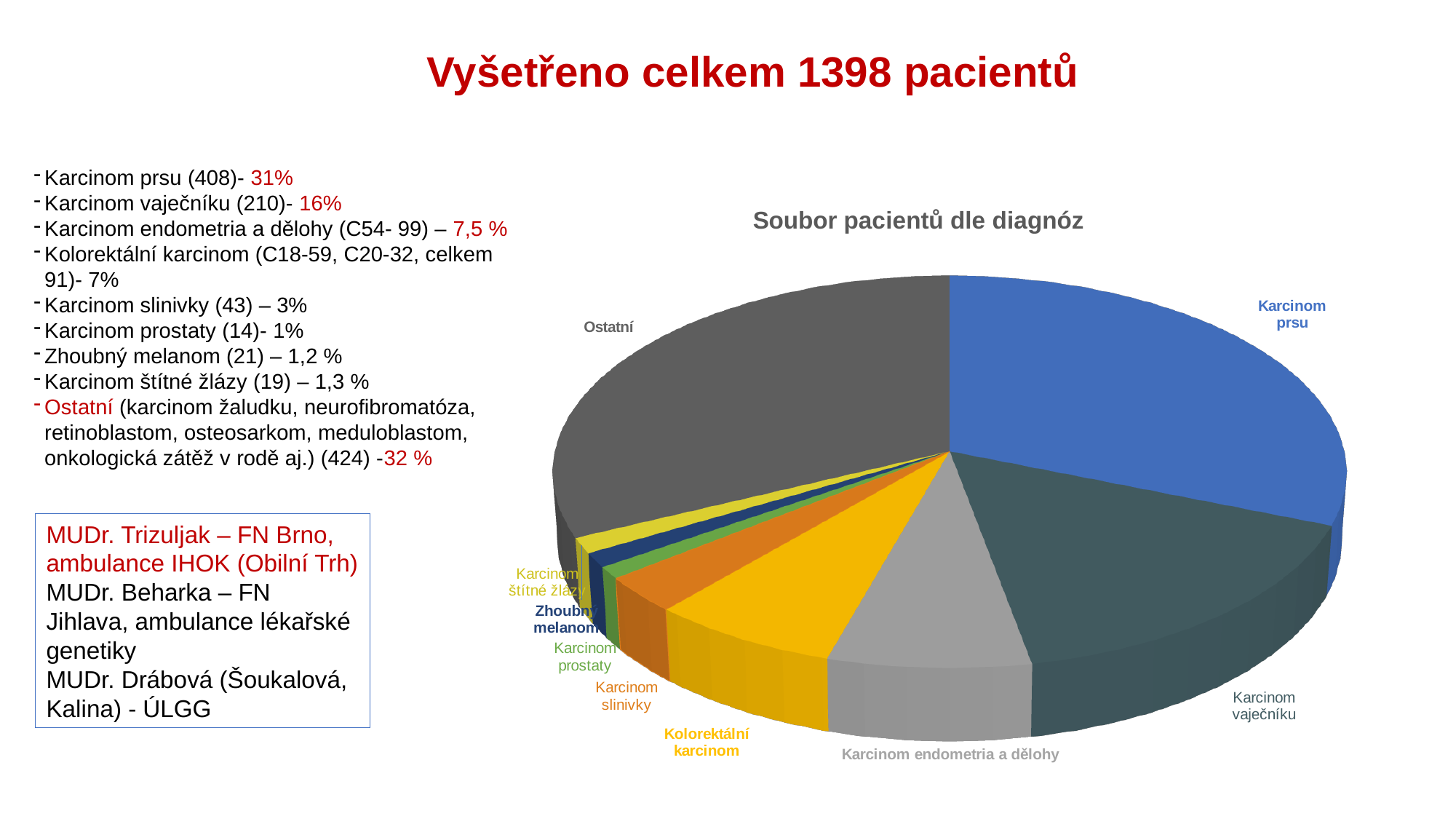
How many slices does the pie chart have? 9 How many patients are in the Karcinom prsu category? 408 How many patients are in the Karcinom vaječníku category? 210 Which category has the largest slice of the pie? Ostatní Which is larger, the slice for Karcinom vaječníku or the slice for Karcinom endometria a dělohy? Karcinom vaječníku What share of the pie does Ostatní represent? 32 % What is the title of the chart? Soubor pacientů dle diagnóz What is the difference in patient count between Karcinom prsu and Karcinom vaječníku? 198 What kind of chart is shown on the slide? pie chart What colour is the Karcinom prsu slice? blue Which category has the smallest slice of the pie? Karcinom prostaty What share of the pie does Karcinom prsu represent? 31%